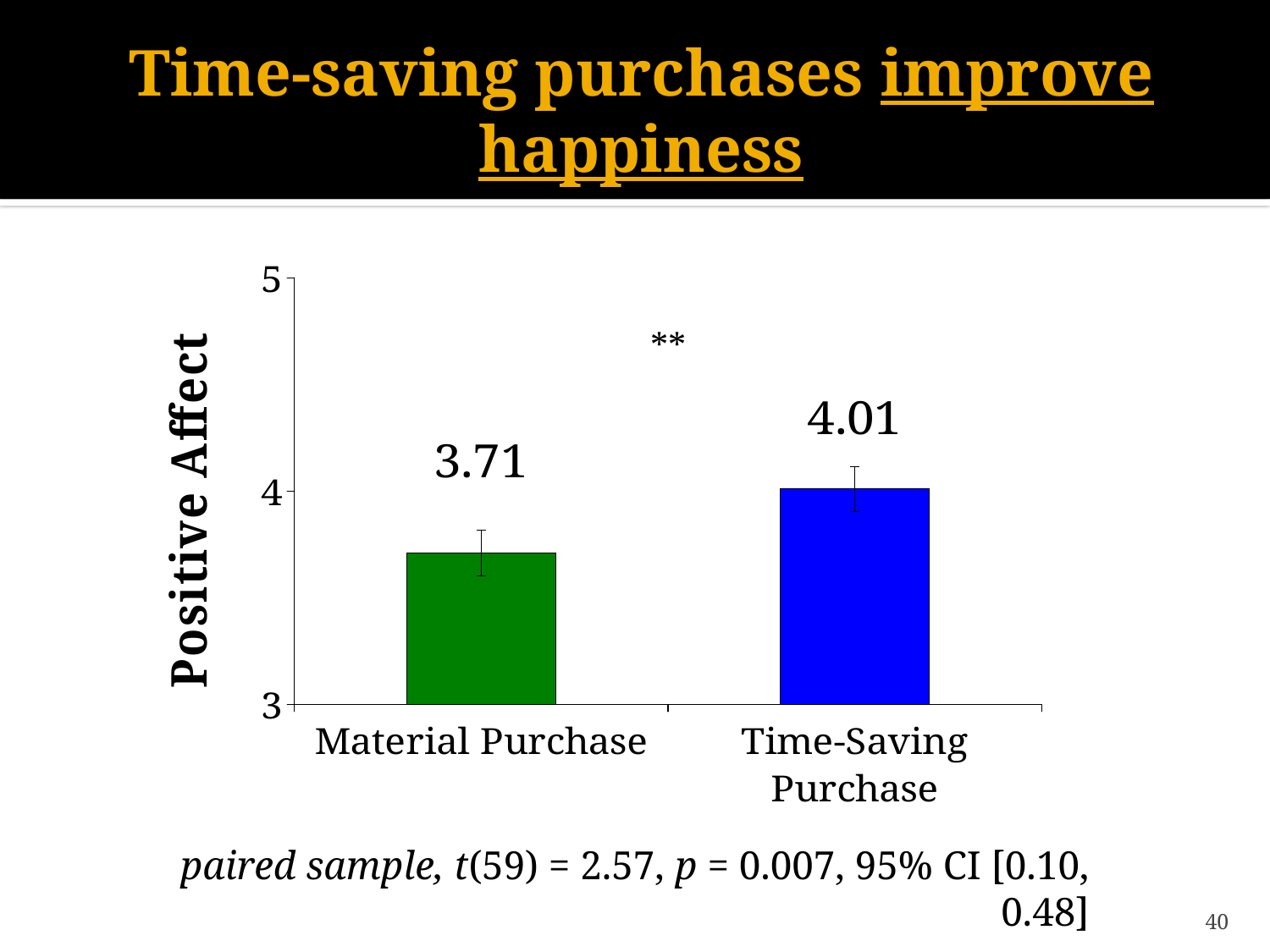
What is the Positive Affect value for Time-Saving Purchase? 4.01 What kind of chart is shown on the slide? bar chart Is the Positive Affect value for Material Purchase larger or smaller than that for Time-Saving Purchase? smaller Which category has the higher Positive Affect value? Time-Saving Purchase What is the label of the y axis? Positive Affect What is the difference in Positive Affect between Time-Saving Purchase and Material Purchase? 0.30 Which category has the lower Positive Affect value? Material Purchase How many categories are shown on the x axis? 2 Is the Positive Affect value for Time-Saving Purchase greater or less than 4? greater What colour is the bar for Time-Saving Purchase? blue What is the Positive Affect value for Material Purchase? 3.71 Is the Positive Affect value for Material Purchase greater or less than 4? less